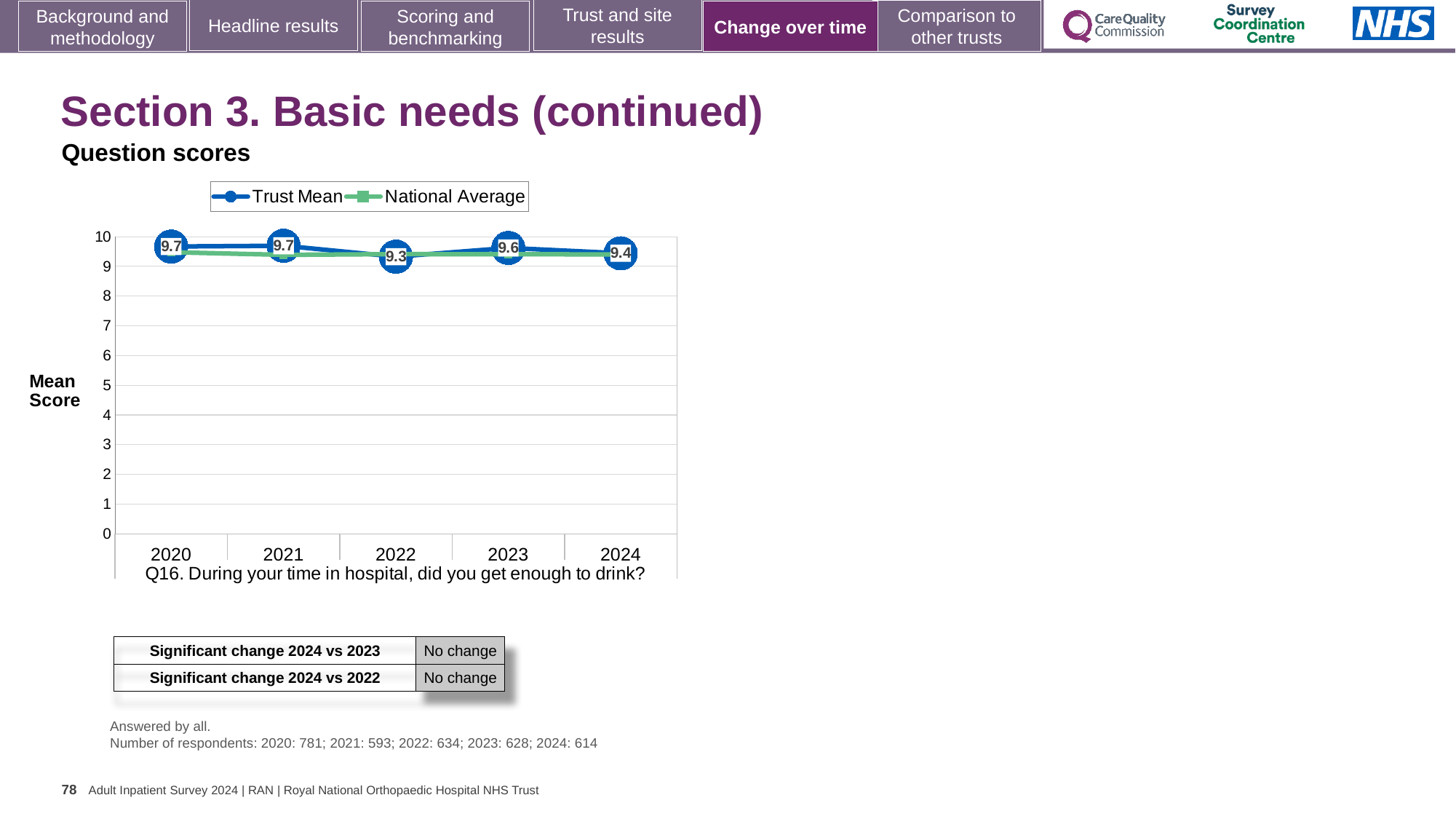
Which question does the chart show scores for? Q16. During your time in hospital, did you get enough to drink? How many series does the chart legend list? 2 Is the Trust Mean score for 2022 greater or less than 9? greater What is the Trust Mean score for 2022? 9.3 How many years are shown on the x axis of the chart? 5 What is the Trust Mean score for 2020? 9.7 What is the Trust Mean score for 2024? 9.4 Does the Trust Mean score rise or fall from 2021 to 2022? Fall What is the difference between the Trust Mean scores for 2021 and 2022? 0.4 Which year has the higher Trust Mean score, 2023 or 2024? 2023 What kind of chart is shown on the slide? Line chart In which year is the Trust Mean score lowest? 2022